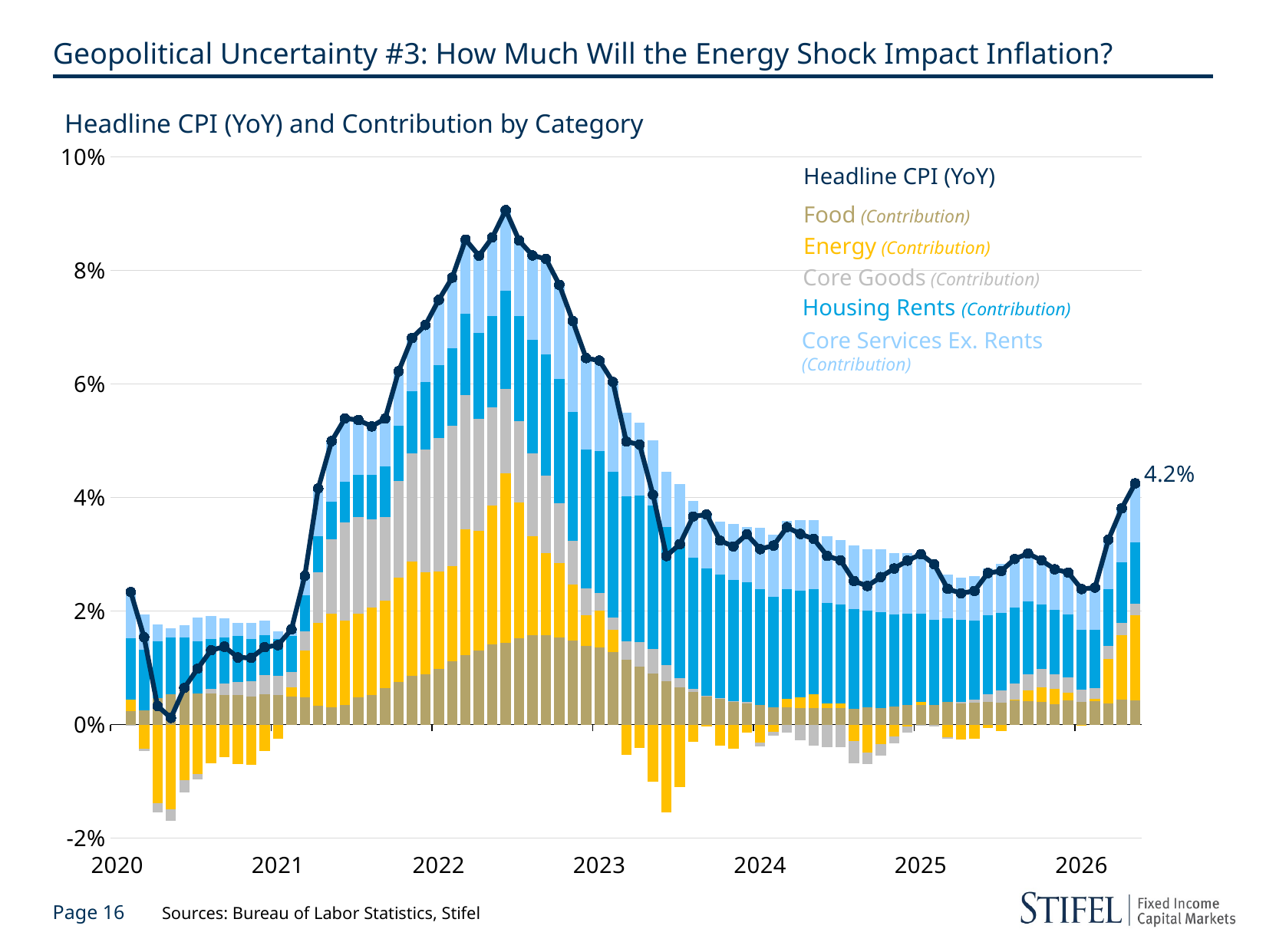
Is the Headline CPI (YoY) value at the start of 2025 greater or less than 4%? less Does the Headline CPI (YoY) line rise or fall between early 2021 and mid-2022? rise Is the peak value of the Headline CPI (YoY) line in 2022 greater or less than 8%? greater Which colour represents the Energy contribution in the chart? Yellow Is the Energy contribution in mid-2023 greater or less than 0%? less How many series does the chart legend list? 6 What kind of chart is shown on the slide? Combined stacked bar and line chart Does the Headline CPI (YoY) line rise or fall between mid-2022 and mid-2023? fall Which is larger: the Headline CPI (YoY) peak in 2022 or the final value of 4.2% in 2026? The 2022 peak What is the title of the chart? Headline CPI (YoY) and Contribution by Category In which year does the Headline CPI (YoY) line reach its highest point? 2022 What is the latest Headline CPI (YoY) value labeled at the right end of the line? 4.2%